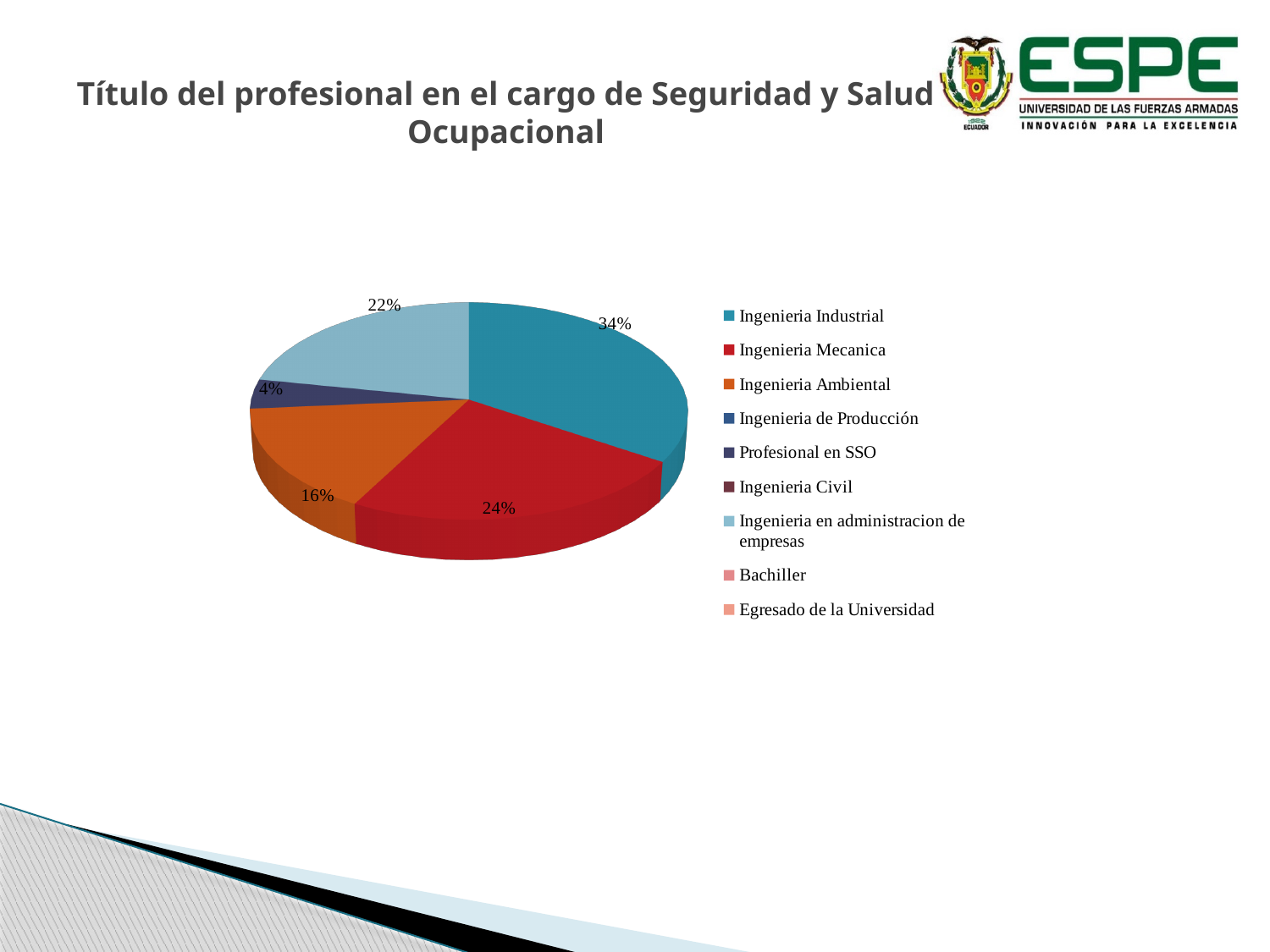
What kind of chart is shown on the slide? Pie chart What is the difference in percentage points between Ingenieria Industrial and Ingenieria Mecanica? 10 percentage points Which has a larger share: Ingenieria Ambiental or Ingenieria en administracion de empresas? Ingenieria en administracion de empresas What percentage of the pie corresponds to Ingenieria Industrial? 34% What percentage of the pie corresponds to Ingenieria Ambiental? 16% What is the smallest percentage label shown on the pie? 4% What is the title of the slide containing the chart? Título del profesional en el cargo de Seguridad y Salud Ocupacional Which category has the largest share of the pie? Ingenieria Industrial What percentage of the pie corresponds to Ingenieria en administracion de empresas? 22% How many categories are listed in the chart's legend? 9 What is the difference in percentage points between Ingenieria Mecanica and Ingenieria Ambiental? 8 percentage points What percentage of the pie corresponds to Ingenieria Mecanica? 24%